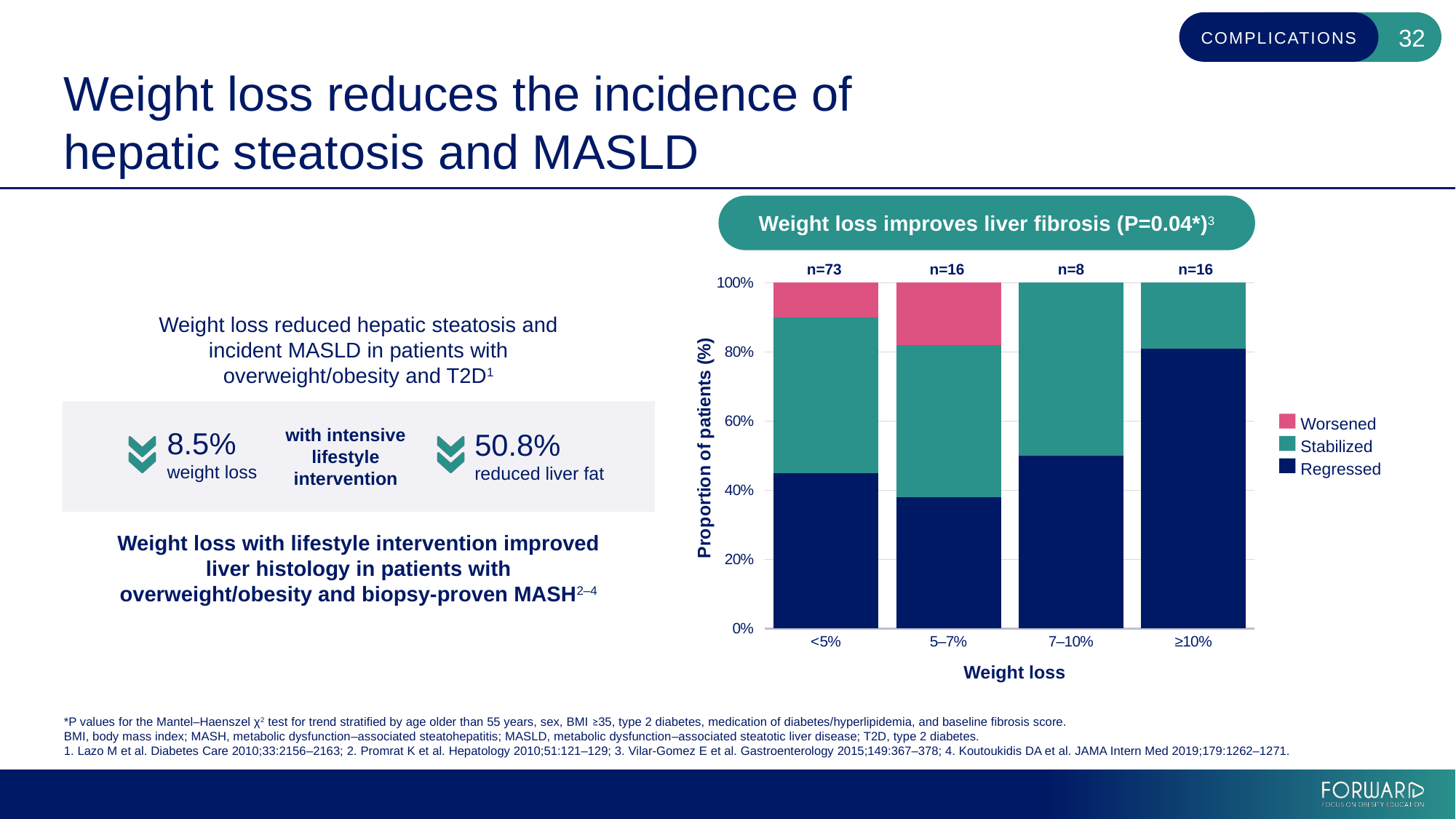
What kind of chart is shown on the slide? Stacked bar chart What is the title of the chart? Weight loss improves liver fibrosis (P=0.04*) What is the number of patients (n) in the <5% weight loss group? n=73 How many weight loss categories are shown on the x axis of the chart? 4 What is the number of patients (n) in the 7–10% weight loss group? n=8 How many series does the chart legend list? 3 What are the three legend entries in the chart? Worsened, Stabilized, Regressed Which weight loss category has the smallest Regressed proportion? 5–7% Which weight loss category has the largest Regressed proportion? ≥10% Is the Regressed proportion for the 5–7% weight loss group greater or less than 40%? less Which weight loss group has a larger Worsened proportion, <5% or 5–7%? 5–7%